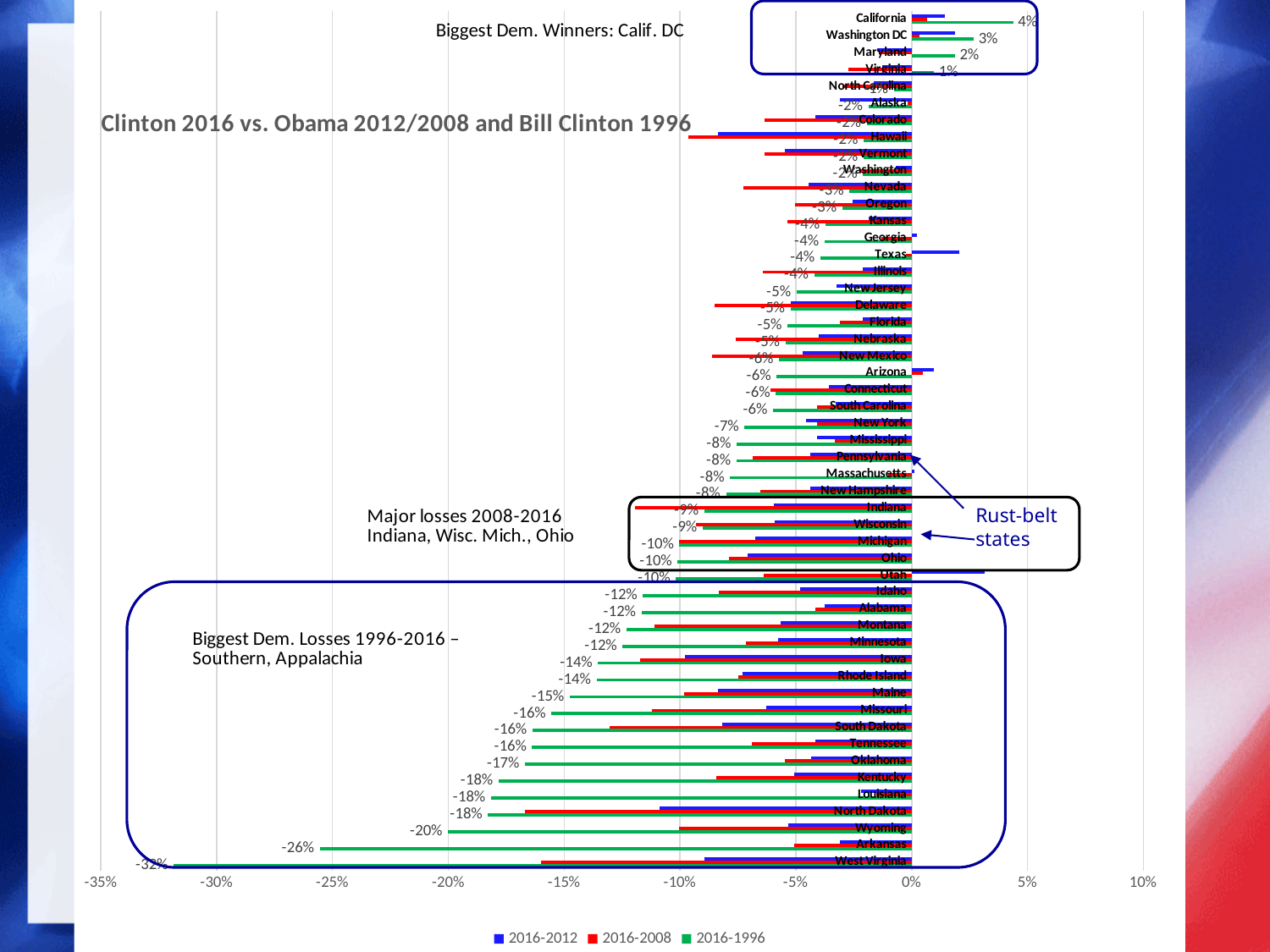
What are the three series listed in the legend? 2016-2012, 2016-2008, 2016-1996 What is the difference between the 2016-1996 values for California and Washington DC? 1% Which state has the highest 2016-1996 value? California What is the 2016-1996 value for Arkansas? -26% What is the title of the chart? Clinton 2016 vs. Obama 2012/2008 and Bill Clinton 1996 What type of chart is shown on the slide? Bar chart What is the 2016-1996 value for California? 4% What is the 2016-1996 value for West Virginia? -32% Which state has the lowest 2016-1996 value? West Virginia What is the 2016-1996 value for Washington DC? 3% Is the 2016-1996 value for West Virginia greater or less than -30%? less How many series does the legend list? 3